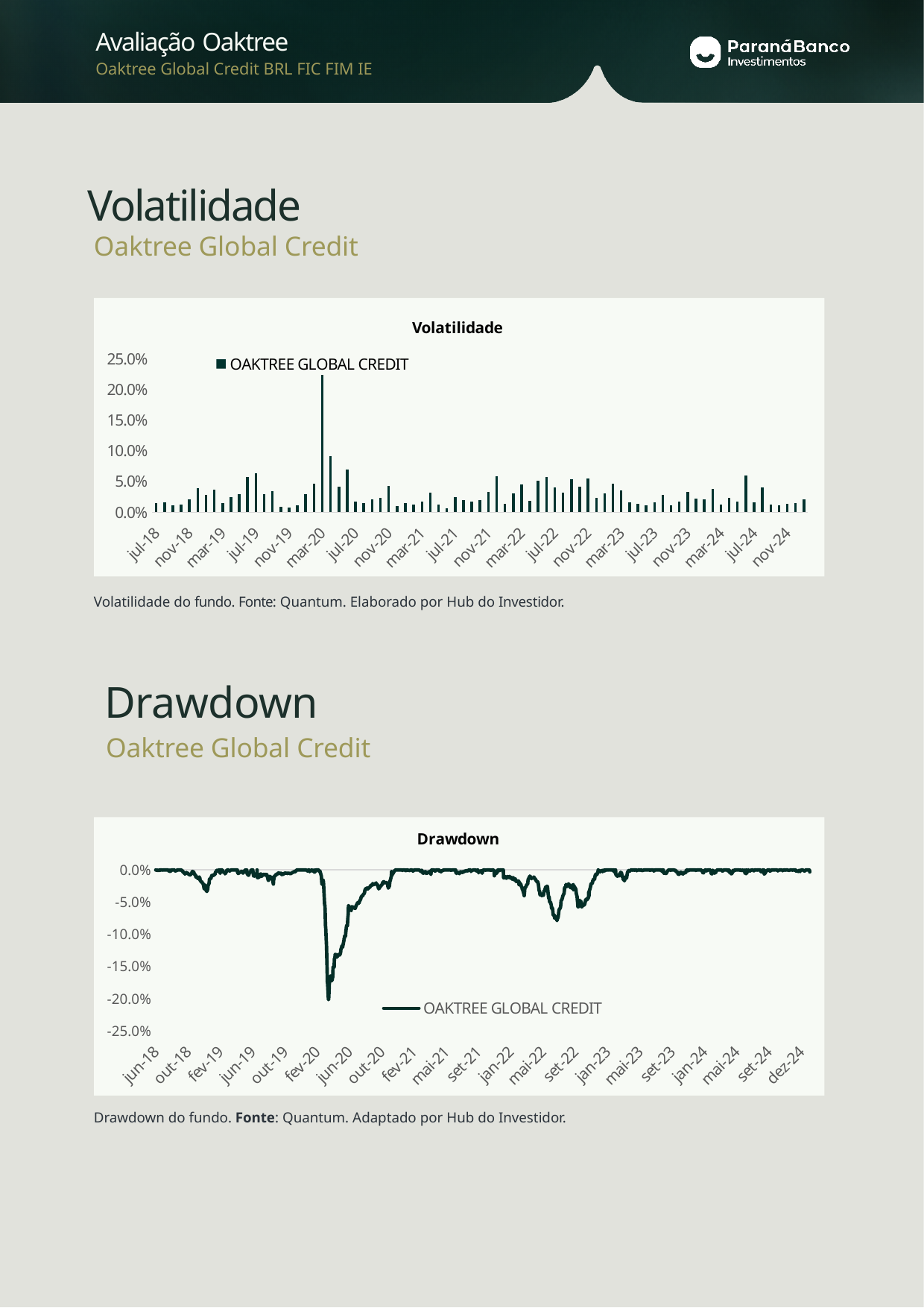
What kind of chart is the Drawdown chart at the bottom of the slide? line chart How many series does the legend of the Drawdown chart list? 1 In the Volatilidade chart, is the bar at jul-18 greater or less than 5.0%? less In the Drawdown chart, is the dip around set-22 greater or less than -10.0%? greater In the Volatilidade chart, around which x-axis label does the tallest bar occur? mar-20 In the Volatilidade chart, is the tallest bar greater or less than 20.0%? greater What kind of chart is the Volatilidade chart at the top of the slide? bar chart What is the highest value shown on the y-axis of the Volatilidade chart? 25.0% How many series does the legend of the Volatilidade chart list? 1 What series name appears in the legend of the Drawdown chart? OAKTREE GLOBAL CREDIT